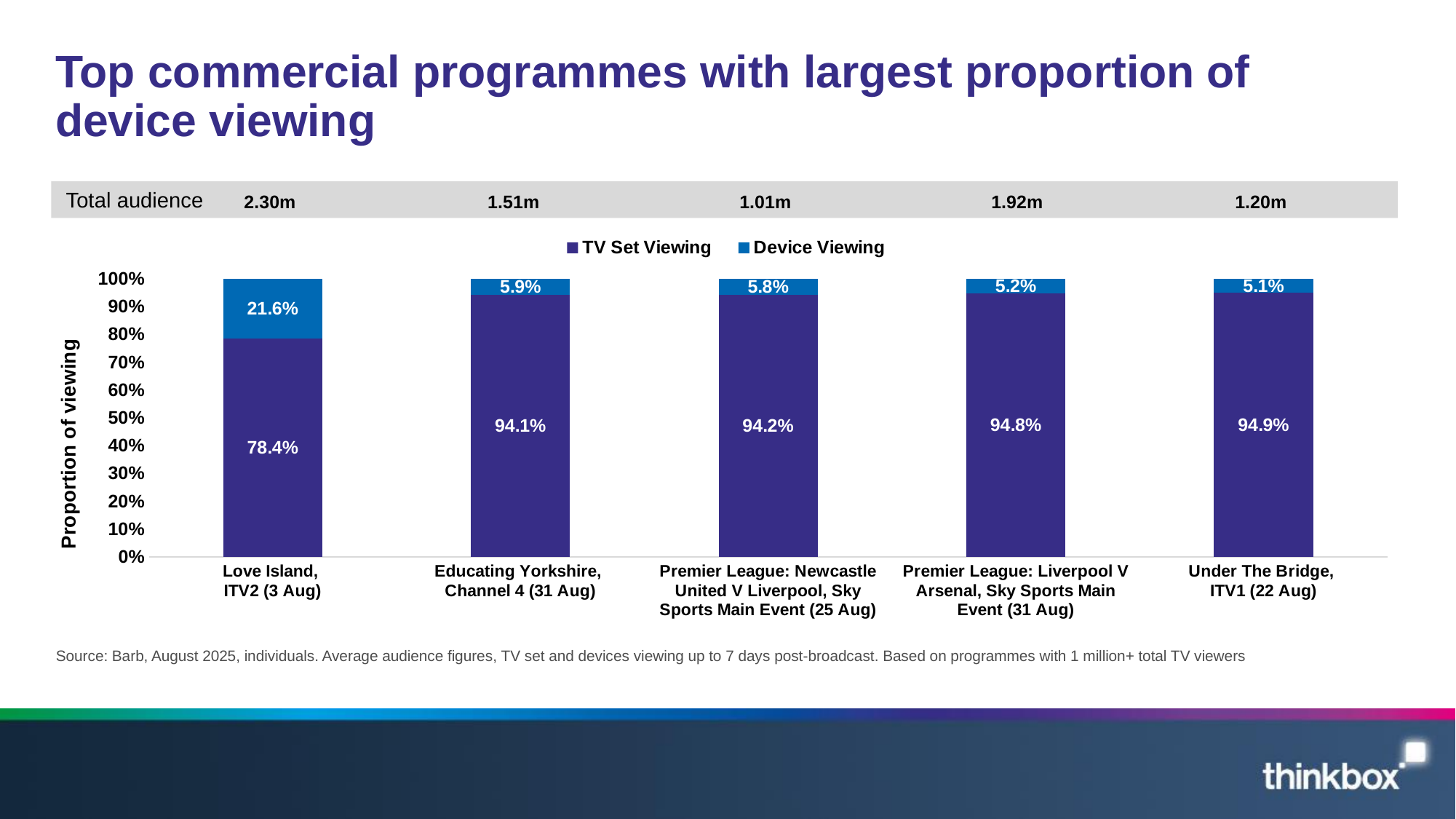
Which programme has the lowest TV Set Viewing proportion? Love Island, ITV2 (3 Aug) Which has a larger Device Viewing value: Premier League: Newcastle United V Liverpool, Sky Sports Main Event (25 Aug) or Premier League: Liverpool V Arsenal, Sky Sports Main Event (31 Aug)? Premier League: Newcastle United V Liverpool, Sky Sports Main Event (25 Aug) What is the TV Set Viewing value for Educating Yorkshire, Channel 4 (31 Aug)? 94.1% What is the difference between the Device Viewing values for Love Island, ITV2 (3 Aug) and Educating Yorkshire, Channel 4 (31 Aug)? 15.7% What kind of chart is shown on the slide? Stacked bar chart What is the Device Viewing value for Under The Bridge, ITV1 (22 Aug)? 5.1% How many series does the legend list? 2 What is the total audience shown for Love Island, ITV2 (3 Aug)? 2.30m What is the Device Viewing value for Love Island, ITV2 (3 Aug)? 21.6% How many programmes are shown on the chart? 5 What is the TV Set Viewing value for Premier League: Liverpool V Arsenal, Sky Sports Main Event (31 Aug)? 94.8% Which programme has the highest Device Viewing proportion? Love Island, ITV2 (3 Aug)